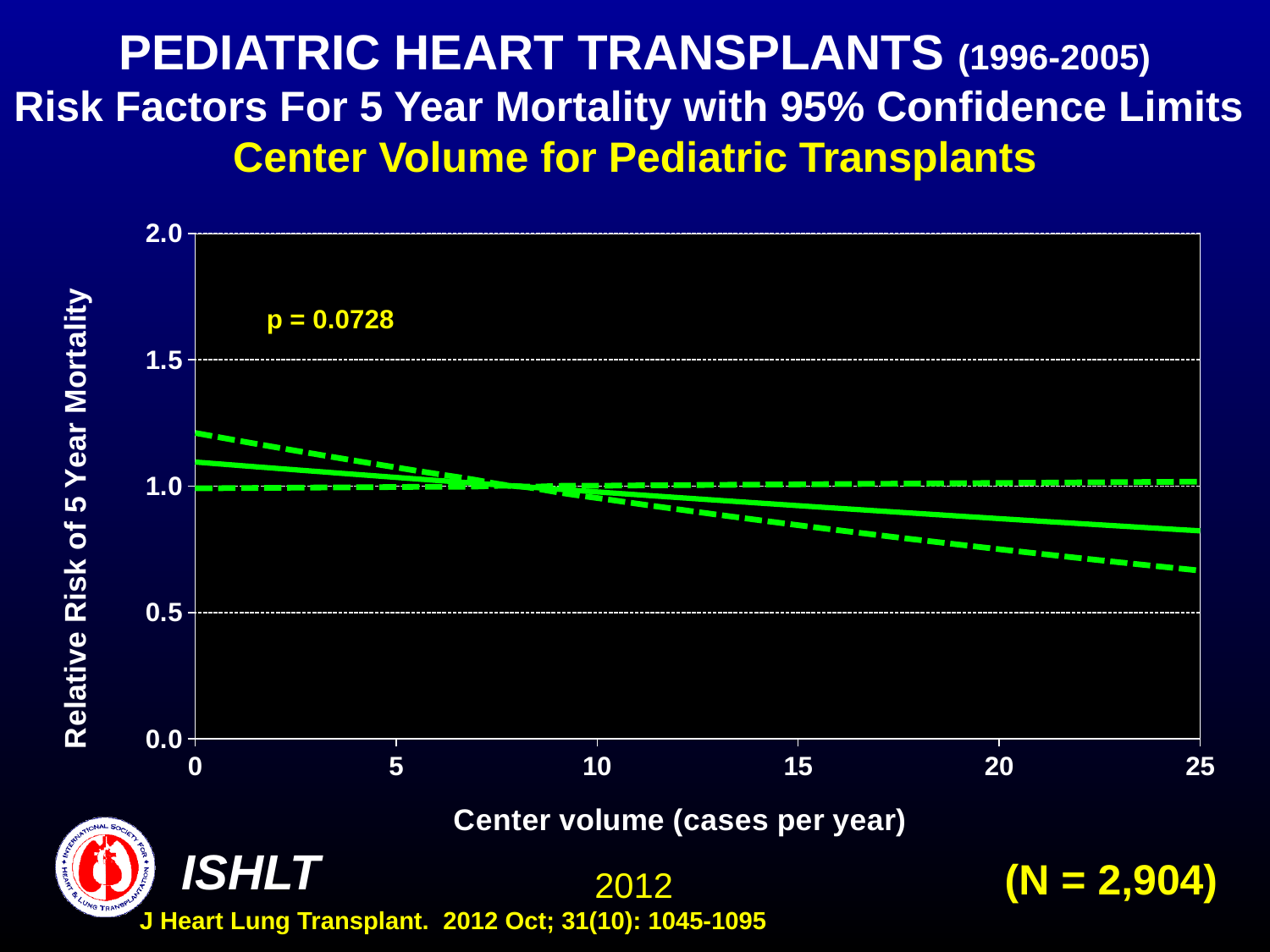
Is the value of the solid relative risk line at a center volume of 0 cases per year greater or less than 1.0? greater Is the solid relative risk line higher at a center volume of 0 or at a center volume of 25 cases per year? 0 Is the upper dashed confidence limit at a center volume of 0 cases per year greater or less than 1.5? less What kind of chart is shown on the slide? line chart Is the value of the solid relative risk line at a center volume of 25 cases per year greater or less than 1.0? less What is the label of the x axis of the chart? Center volume (cases per year) What p-value is printed on the chart? p = 0.0728 How many lines are plotted on the chart? 3 Does the solid line for relative risk of 5 year mortality rise or fall as center volume increases from 0 to 25 cases per year? fall What is the highest center volume shown on the x axis of the chart? 25 What is the highest value shown on the y axis of the chart? 2.0